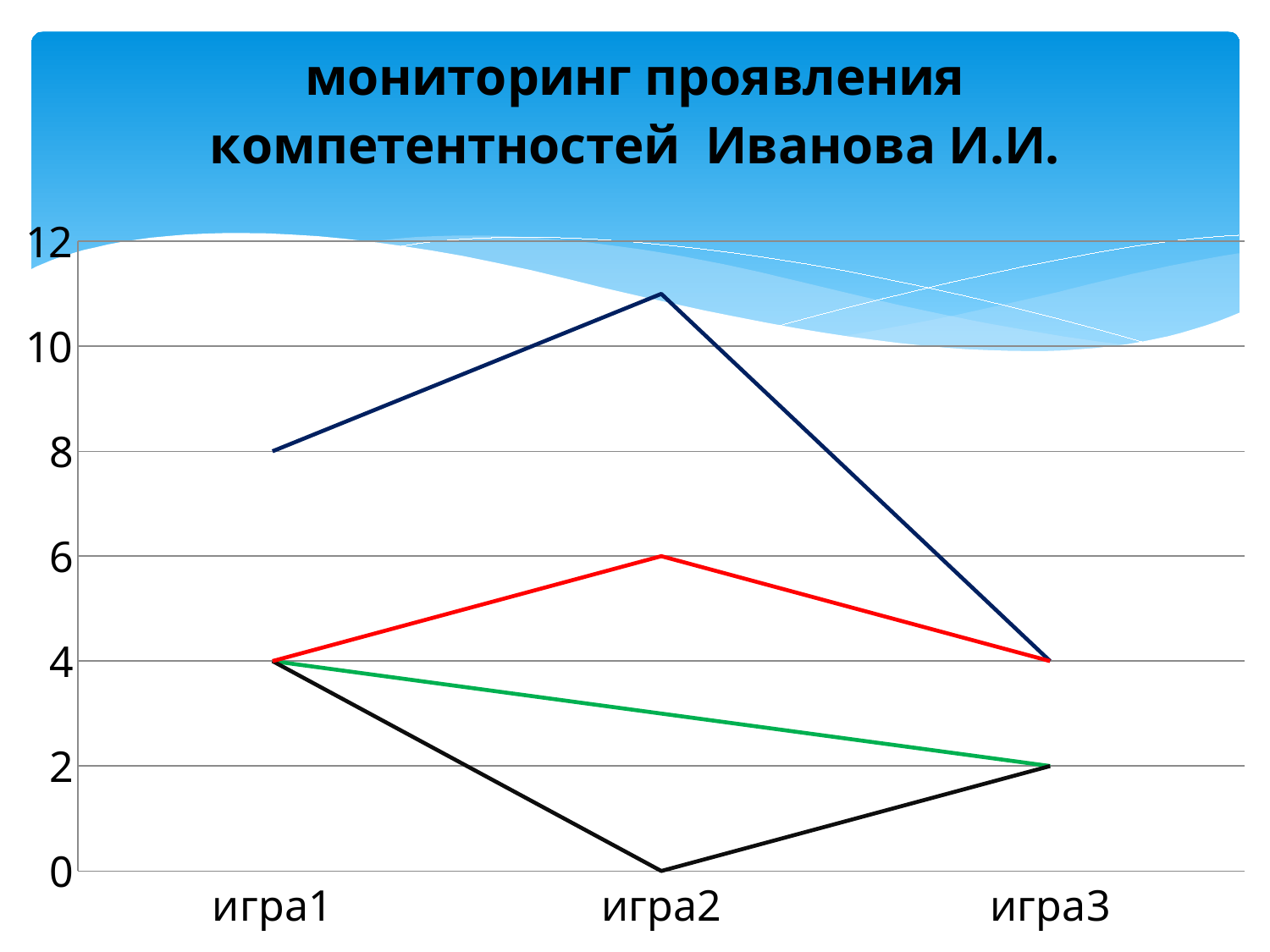
By how much does the red line's value at игра2 exceed its value at игра1? 2 Which line has the lowest value at игра2? black What kind of chart is shown on the slide? line chart At игра3, which is larger: the value of the red line or the value of the black line? red line What is the value of the dark blue line at игра1? 8 What is the value of the green line at игра3? 2 What is the value of the black line at игра2? 0 Is the value of the dark blue line at игра2 greater or less than 10? greater How many categories are shown on the x axis? 3 What is the value of the red line at игра2? 6 Which line has the highest value at игра2? dark blue Does the green line rise or fall from игра1 to игра3? fall